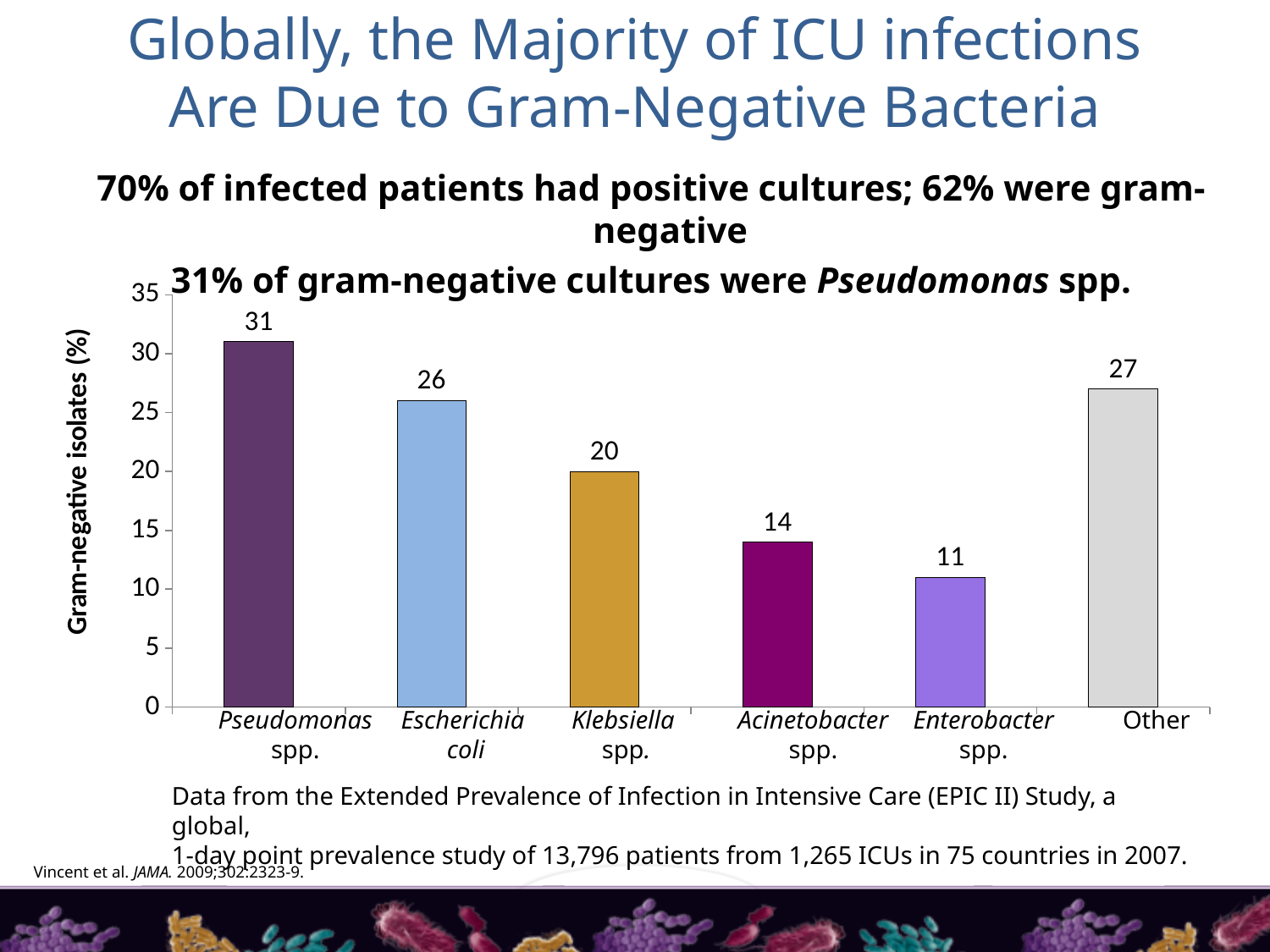
Which category has the lowest value? Enterobacter spp. What is the label of the y axis? Gram-negative isolates (%) What kind of chart is shown on the slide? Bar chart How many categories are shown on the x axis? 6 What is the value for Acinetobacter spp.? 14 What is the value for Escherichia coli? 26 Which category has the highest value? Pseudomonas spp. What is the difference between the values for Pseudomonas spp. and Other? 4 Which is larger, the value for Escherichia coli or the value for Other? Other What is the value for Klebsiella spp.? 20 What is the value for Enterobacter spp.? 11 What is the value for Pseudomonas spp.? 31